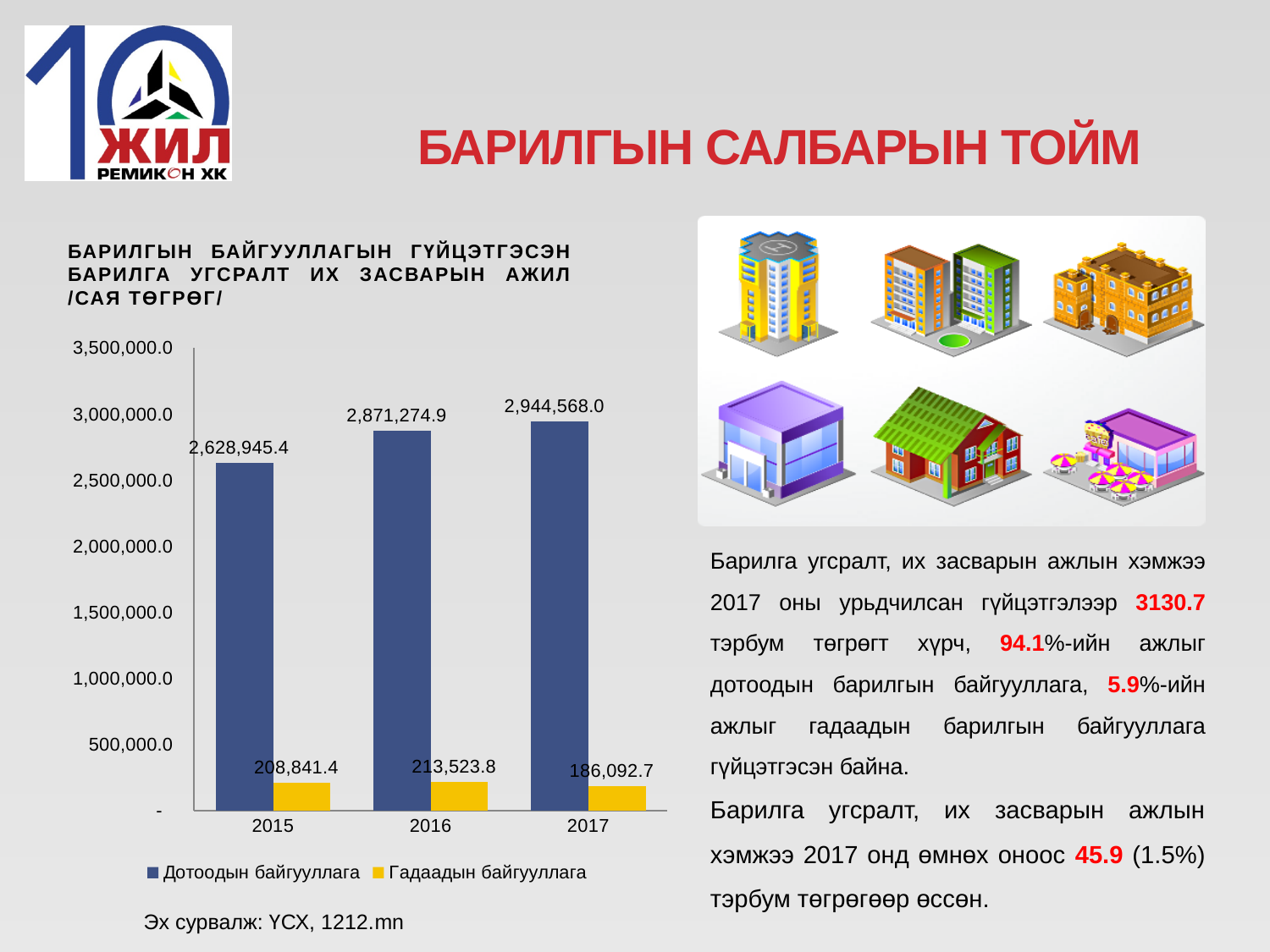
What is the difference between the Дотоодын байгууллага values for 2017 and 2016? 73,293.1 What is the value for Гадаадын байгууллага in 2015? 208,841.4 What kind of chart is shown on the slide? bar chart What is the value for Дотоодын байгууллага in 2015? 2,628,945.4 Which is larger: the Гадаадын байгууллага value for 2016 or for 2017? 2016 What is the value for Дотоодын байгууллага in 2017? 2,944,568.0 What is the difference between the Гадаадын байгууллага values for 2016 and 2017? 27,431.1 In which year is the value for Гадаадын байгууллага highest? 2016 How many series does the chart legend list? 2 In which year is the value for Дотоодын байгууллага lowest? 2015 Is the value for Дотоодын байгууллага in 2016 greater or less than 2,500,000.0? greater How many years are shown on the x axis of the chart? 3